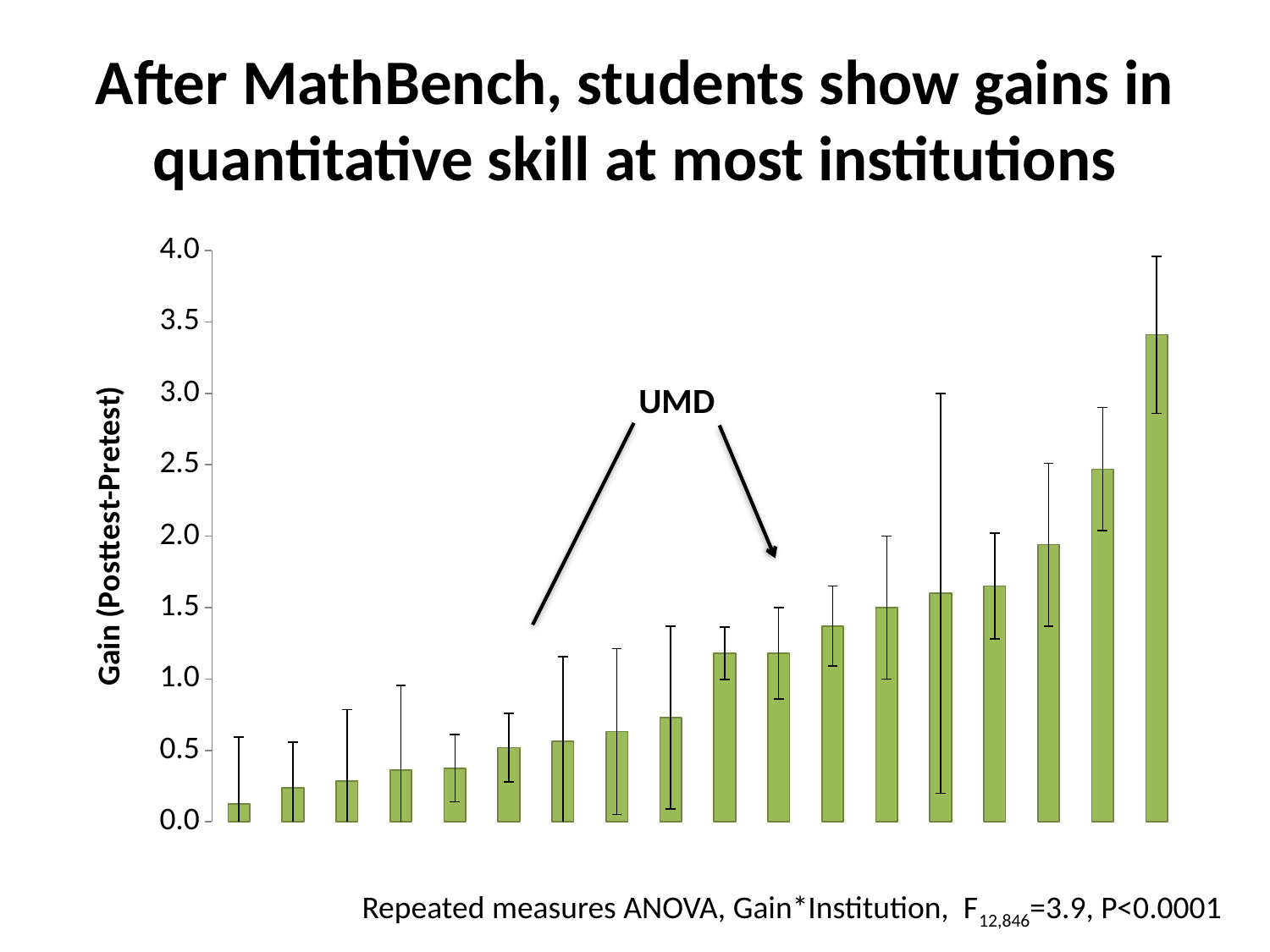
What kind of chart is shown on the slide? bar chart What is the label on the vertical axis of the chart? Gain (Posttest-Pretest) What is the highest tick value shown on the vertical axis? 4.0 Which institution is singled out with an arrow annotation on the chart? UMD Is the value of the leftmost bar greater or less than 0.5? less Do the bar values rise or fall from left to right along the x axis? rise Is the value of the bar labelled UMD greater or less than 1.5? less How many bars are plotted in the chart? 18 Which bar has the highest gain, the leftmost or the rightmost? the rightmost Is the value of the bar labelled UMD greater or less than 1.0? greater Which bar has the lowest gain, the leftmost or the rightmost? the leftmost